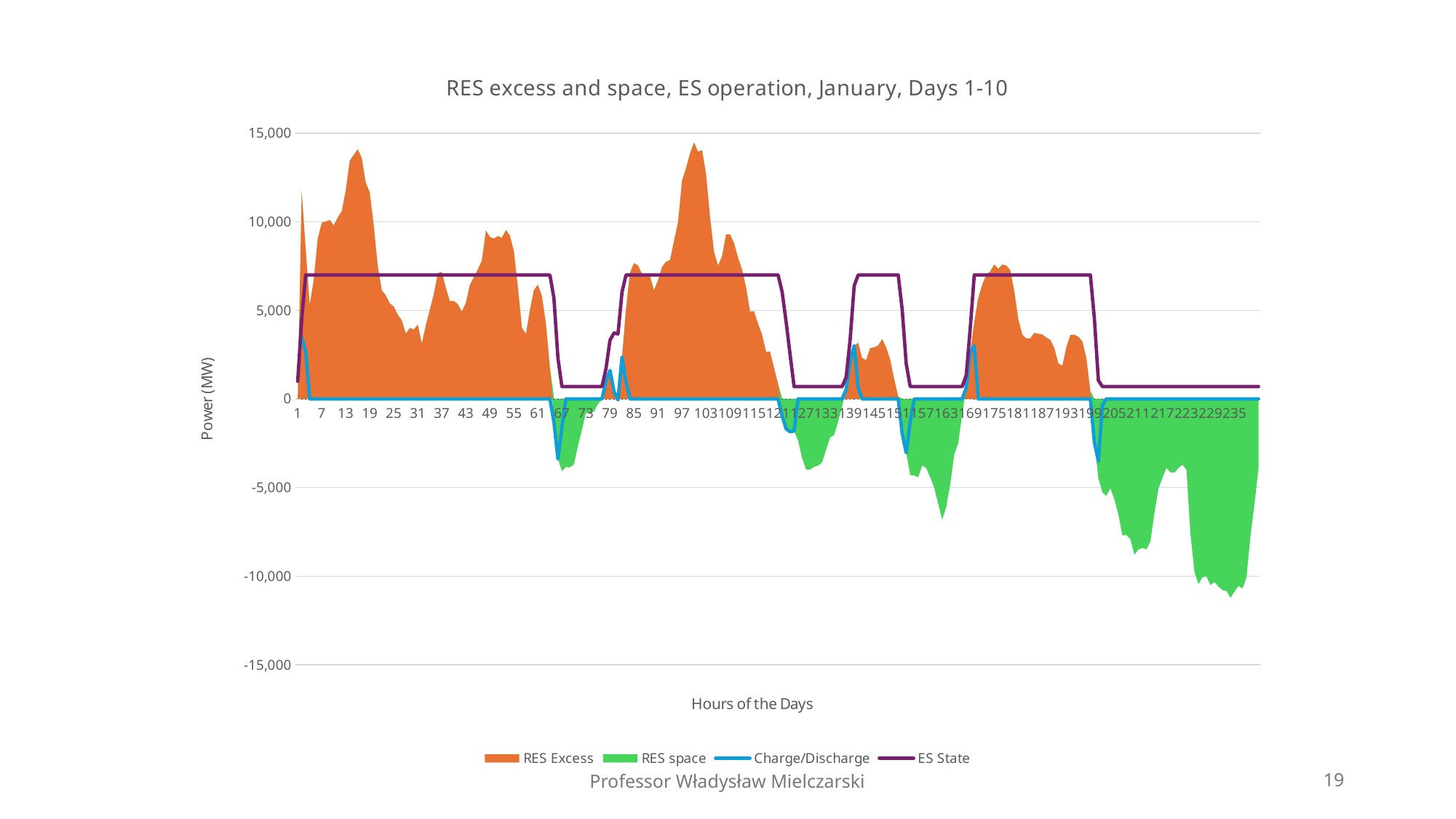
What is the title of the chart? RES excess and space, ES operation, January, Days 1-10 How many series does the chart legend list? 4 What kind of chart is shown on the slide? Area chart with line series Is the highest value of the Charge/Discharge series greater or less than 5,000? less Which series reaches a higher peak value, RES Excess or ES State? RES Excess Is the lowest value of the RES space series greater or less than -5,000? less Is the value of the RES space series at hour 235 greater or less than -5,000? less What is the label of the vertical axis? Power (MW)